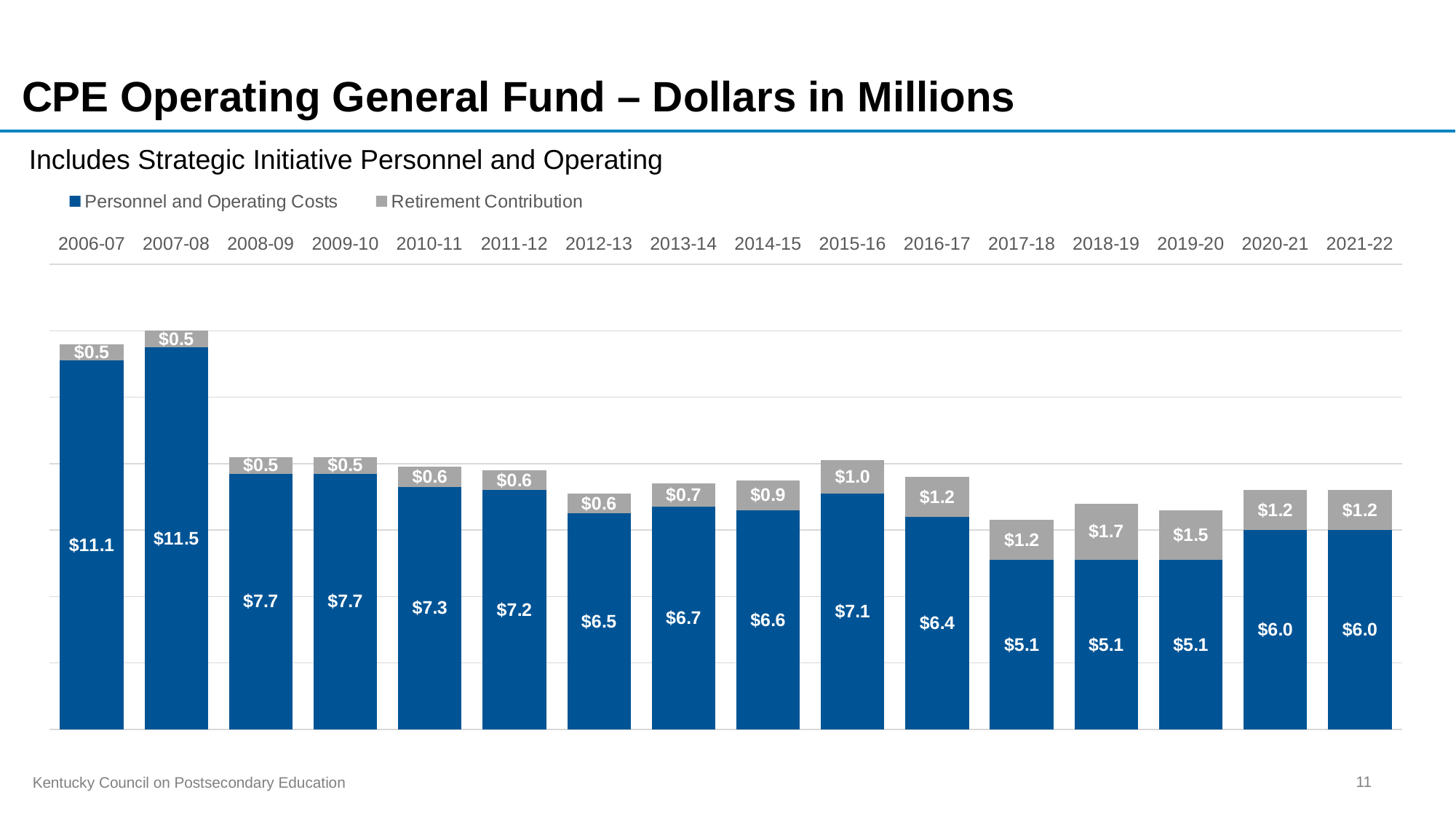
Which series is shown in grey in the legend? Retirement Contribution How many series does the legend list? 2 What is the Personnel and Operating Costs value for 2021-22? $6.0 How many fiscal years are shown on the x axis? 16 Which is larger, the Personnel and Operating Costs value for 2013-14 or for 2014-15? 2013-14 Which year has the highest Personnel and Operating Costs value? 2007-08 What is the Personnel and Operating Costs value for 2010-11? $7.3 What is the difference between the Personnel and Operating Costs values for 2007-08 and 2008-09? $3.8 What kind of chart is shown on the slide? Stacked bar chart Which year has the highest Retirement Contribution value? 2018-19 What is the total of the stacked bar for 2007-08? $12.0 What is the Retirement Contribution value for 2018-19? $1.7